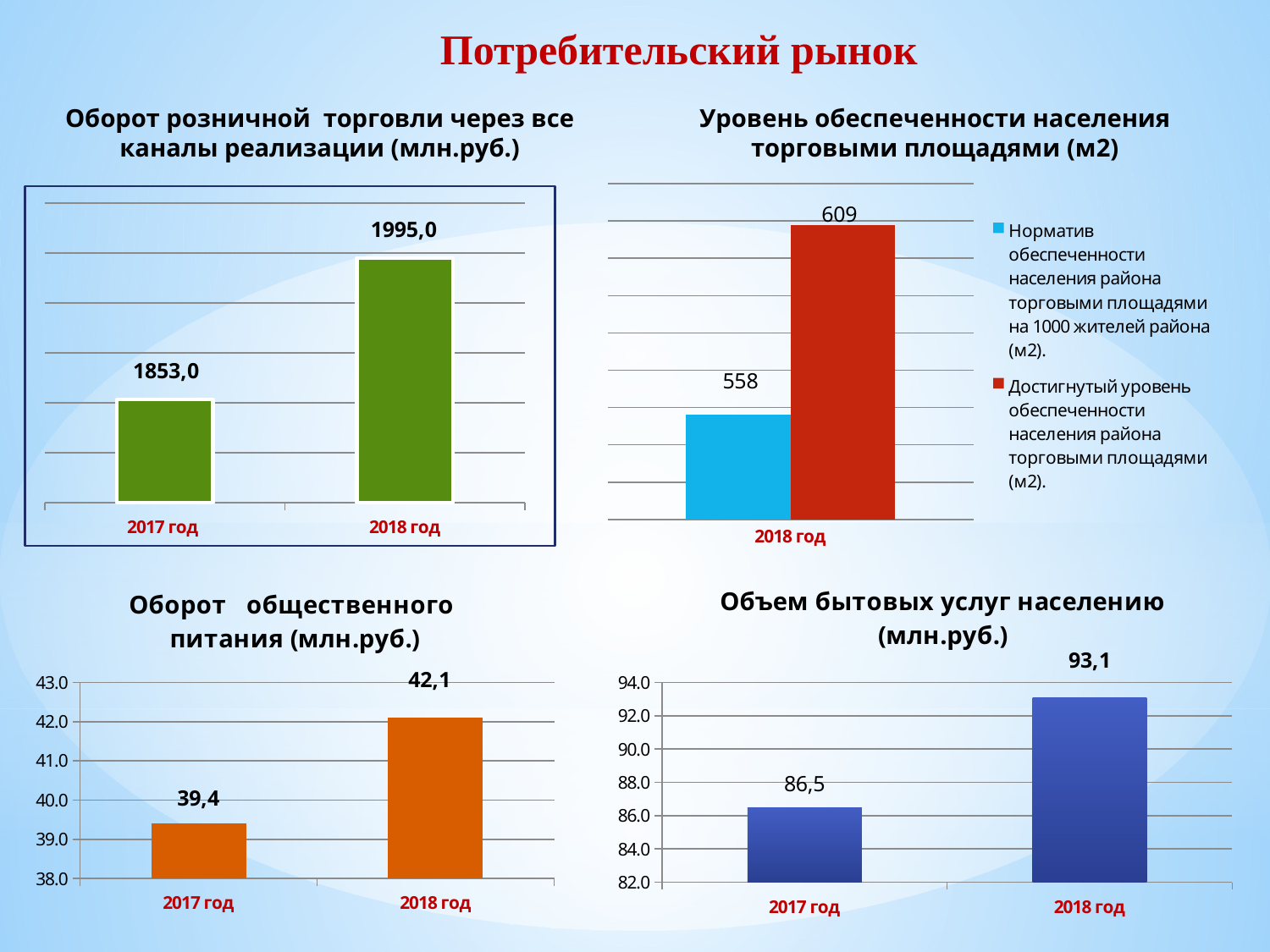
In the chart 'Оборот розничной торговли через все каналы реализации (млн.руб.)', what is the value for 2017 год? 1853,0 In the chart 'Оборот розничной торговли через все каналы реализации (млн.руб.)', what is the difference between the 2018 год and 2017 год values? 142,0 In the chart 'Оборот общественного питания (млн.руб.)', what is the value for 2017 год? 39,4 What kind of chart is 'Объем бытовых услуг населению (млн.руб.)'? Bar chart In the chart 'Оборот общественного питания (млн.руб.)', which year has the higher value? 2018 год In the chart 'Объем бытовых услуг населению (млн.руб.)', what is the difference between the 2018 год and 2017 год values? 6,6 In the chart 'Оборот розничной торговли через все каналы реализации (млн.руб.)', what is the value for 2018 год? 1995,0 In the chart 'Уровень обеспеченности населения торговыми площадями (м2)', by how much does the achieved level (609) exceed the norm (558)? 51 In the chart 'Уровень обеспеченности населения торговыми площадями (м2)', what is the value of the 'Достигнутый уровень обеспеченности' series for 2018 год? 609 In the chart 'Объем бытовых услуг населению (млн.руб.)', what is the value for 2018 год? 93,1 In the chart 'Уровень обеспеченности населения торговыми площадями (м2)', what is the value of the 'Норматив обеспеченности' series? 558 In the chart 'Уровень обеспеченности населения торговыми площадями (м2)', how many series does the legend list? 2